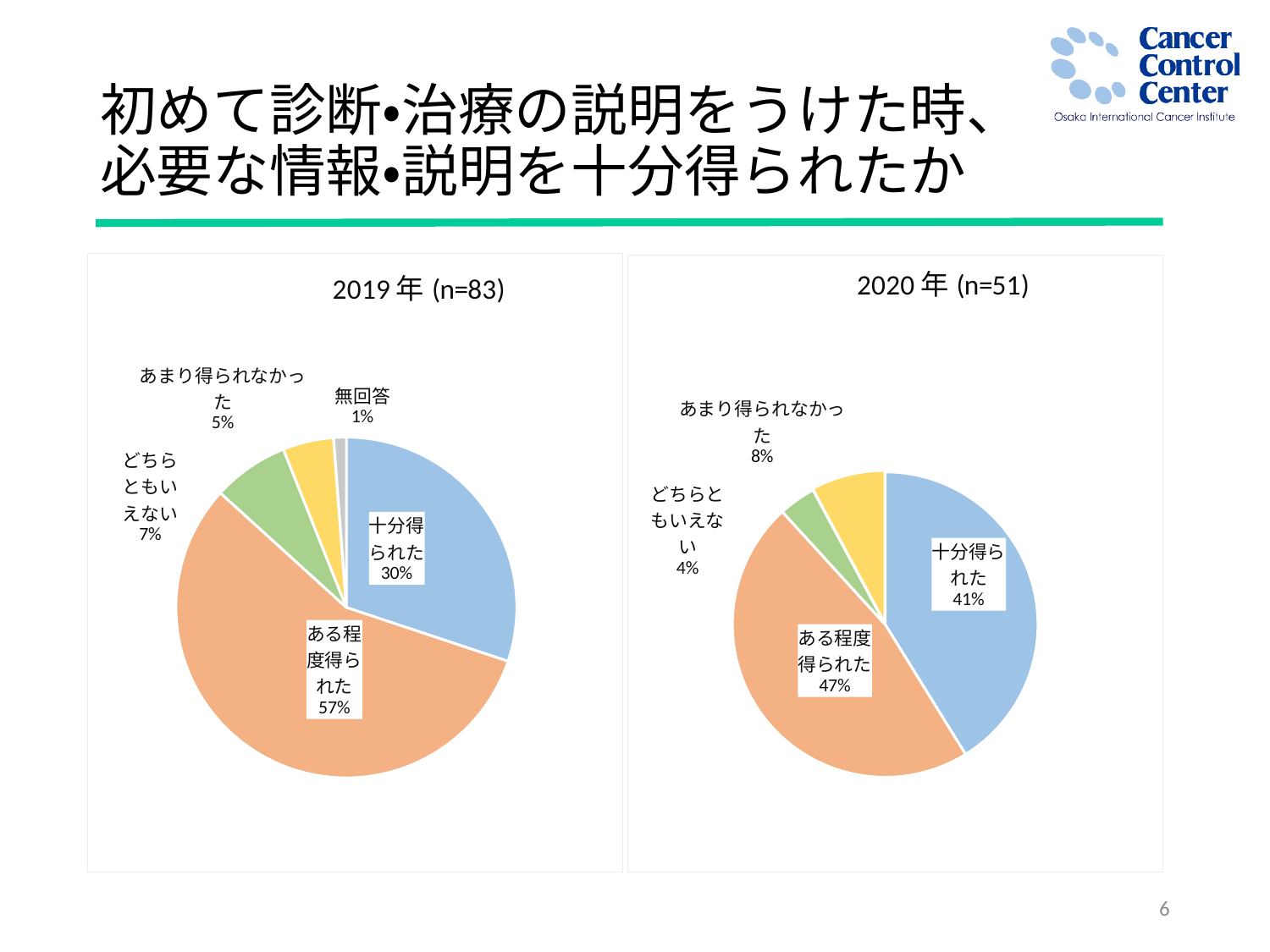
What kind of chart is the 2020年 (n=51) chart? pie chart In the 2020年 (n=51) chart, what share is labelled for 十分得られた? 41% How many categories are shown in the 2020年 (n=51) chart? 4 In the 2020年 (n=51) chart, which category has the smallest slice? どちらともいえない In the 2019年 (n=83) chart, which category has the largest slice? ある程度得られた Which is larger: 十分得られた in the 2019年 (n=83) chart or 十分得られた in the 2020年 (n=51) chart? 2020年 (n=51) How many categories are shown in the 2019年 (n=83) chart? 5 In the 2019年 (n=83) chart, which category has the smallest slice? 無回答 In the 2020年 (n=51) chart, what share is labelled for あまり得られなかった? 8% In the 2020年 (n=51) chart, what is the difference in percentage points between ある程度得られた and 十分得られた? 6 In the 2019年 (n=83) chart, what share is labelled for ある程度得られた? 57%